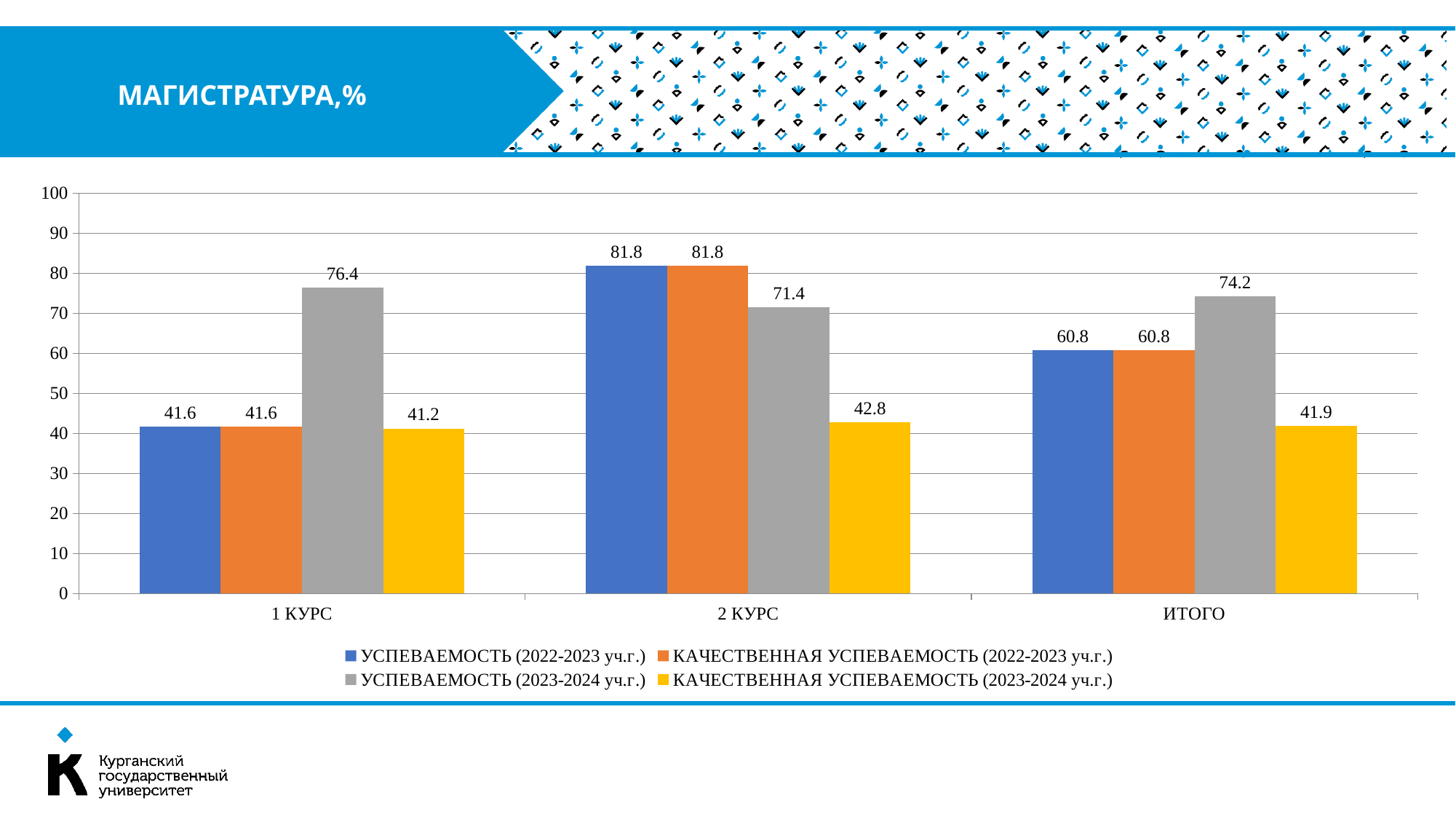
Which category has the highest value for УСПЕВАЕМОСТЬ (2022-2023 уч.г.)? 2 КУРС How many categories are shown on the x axis? 3 How many series does the legend list? 4 What is the value of УСПЕВАЕМОСТЬ (2022-2023 уч.г.) for ИТОГО? 60.8 What is the value of УСПЕВАЕМОСТЬ (2023-2024 уч.г.) for 1 КУРС? 76.4 What kind of chart is shown on the slide? bar chart What is the difference between УСПЕВАЕМОСТЬ (2023-2024 уч.г.) and КАЧЕСТВЕННАЯ УСПЕВАЕМОСТЬ (2023-2024 уч.г.) for 1 КУРС? 35.2 What is the value of КАЧЕСТВЕННАЯ УСПЕВАЕМОСТЬ (2023-2024 уч.г.) for 2 КУРС? 42.8 For 2 КУРС, which is larger: УСПЕВАЕМОСТЬ (2022-2023 уч.г.) or УСПЕВАЕМОСТЬ (2023-2024 уч.г.)? УСПЕВАЕМОСТЬ (2022-2023 уч.г.) Which category has the lowest value for КАЧЕСТВЕННАЯ УСПЕВАЕМОСТЬ (2023-2024 уч.г.)? 1 КУРС What is the title of the slide? МАГИСТРАТУРА,% Is the value of УСПЕВАЕМОСТЬ (2023-2024 уч.г.) for ИТОГО greater or less than 70? greater